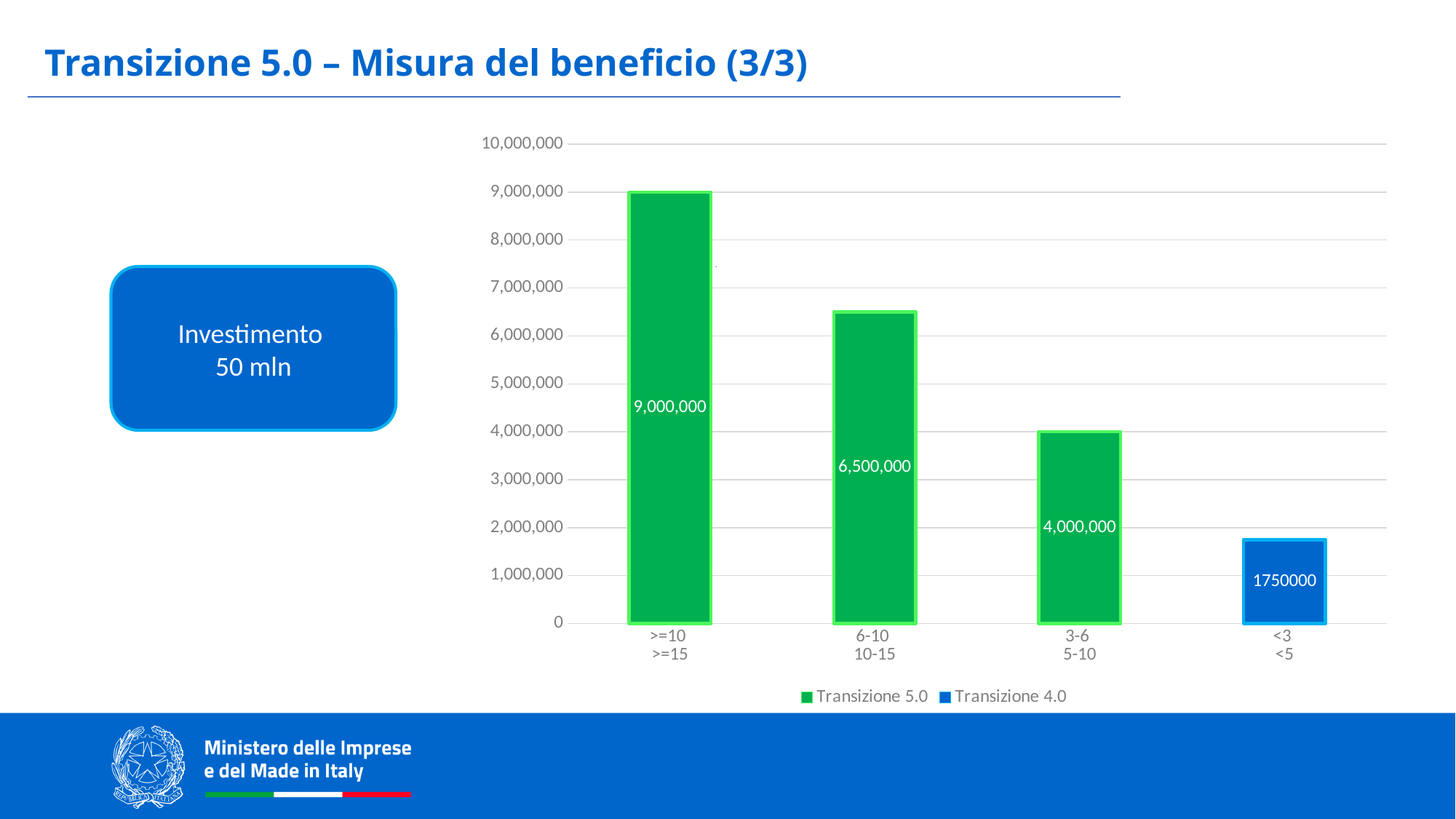
What is the value of the bar for the category "3-6 / 5-10"? 4,000,000 Do the values rise or fall from left to right along the x axis? Fall How many series does the legend list? 2 What is the value of the bar for the category "6-10 / 10-15"? 6,500,000 What is the value of the bar for the category ">=10 / >=15"? 9,000,000 Which is larger, the value for "6-10 / 10-15" or the value for "3-6 / 5-10"? 6-10 / 10-15 How many categories are shown on the x axis? 4 Which category has the highest value? >=10 / >=15 What is the value of the bar for the category "<3 / <5"? 1750000 What is the difference between the values for ">=10 / >=15" and "6-10 / 10-15"? 2,500,000 Which category has the lowest value? <3 / <5 What kind of chart is shown on the slide? Bar chart